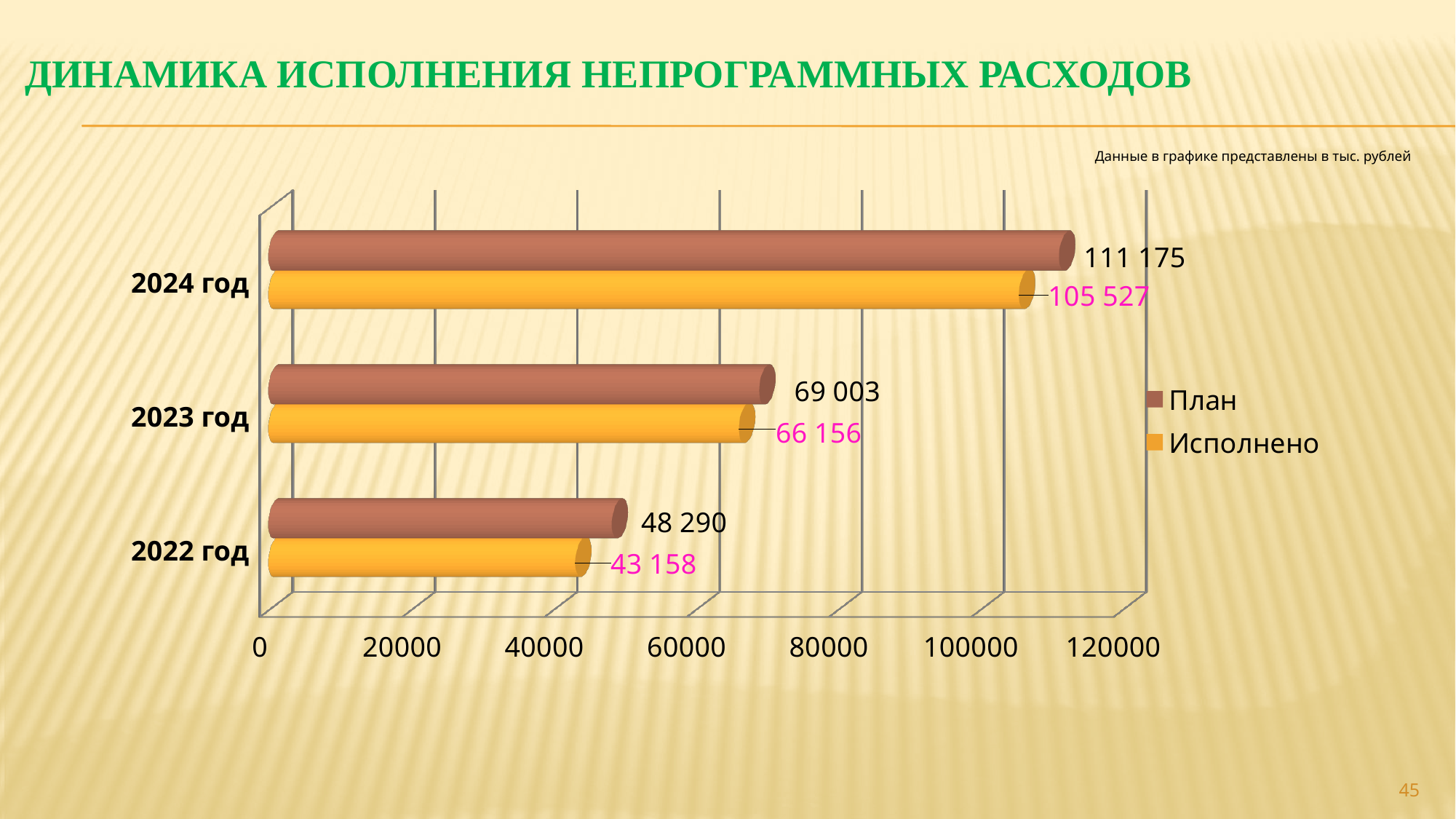
Which year has the lowest План value? 2022 год What is the План value for 2024 год? 111 175 What kind of chart is shown on the slide? Bar chart Which year has the highest Исполнено value? 2024 год How many years are shown on the chart? 3 Which is larger for 2023 год: План or Исполнено? План What is the План value for 2022 год? 48 290 What is the Исполнено value for 2024 год? 105 527 What is the difference between План and Исполнено for 2022 год? 5 132 What is the Исполнено value for 2023 год? 66 156 What is the difference between План and Исполнено for 2024 год? 5 648 How many series does the legend list? 2